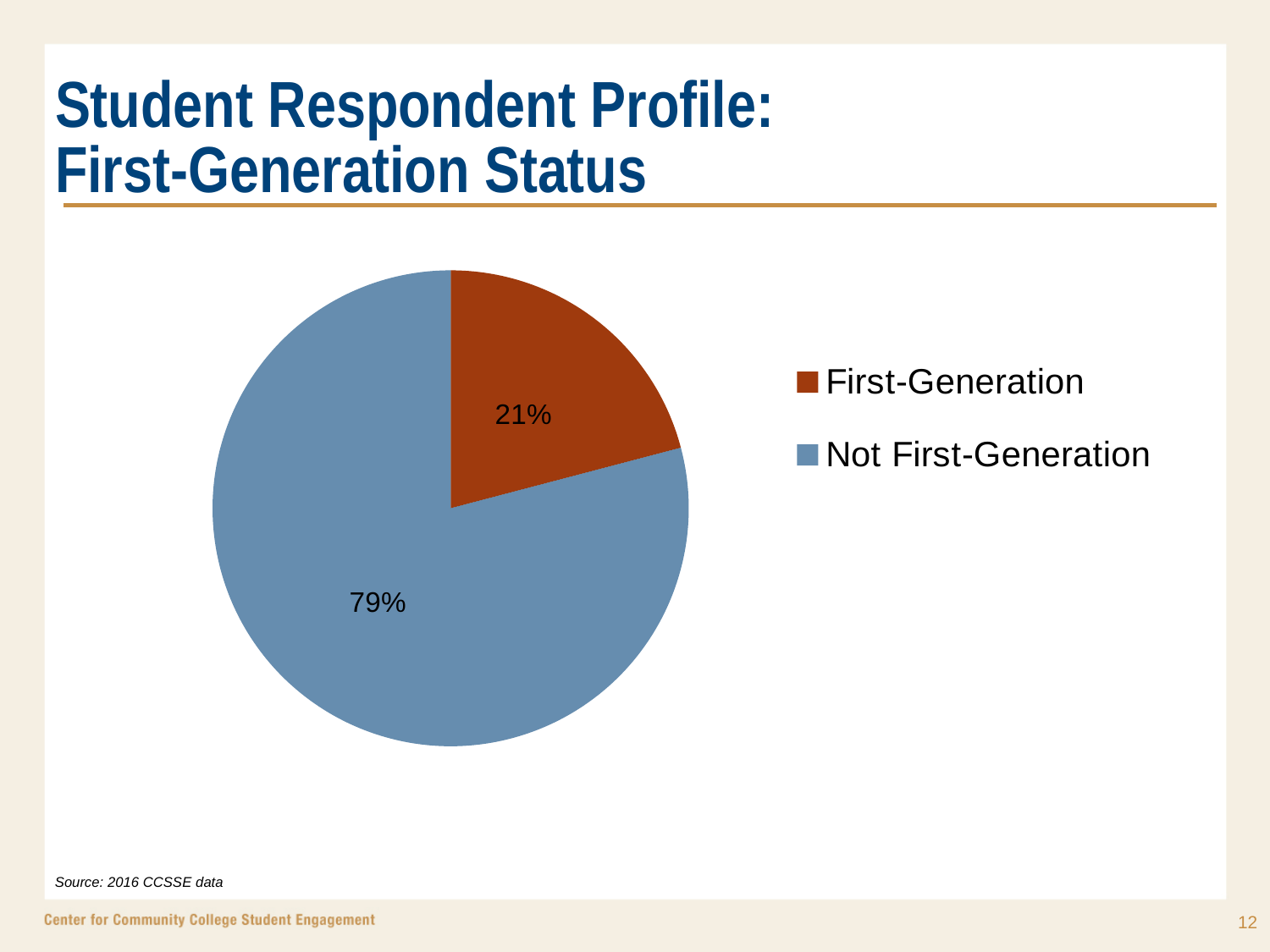
Which category has the largest share of the pie? Not First-Generation What is the source cited for the chart data? 2016 CCSSE data Which is larger, the First-Generation share or the Not First-Generation share? Not First-Generation How many entries does the legend list? 2 What is the difference in percentage points between Not First-Generation and First-Generation? 58 What share of the pie does the First-Generation slice represent? 21% How many slices does the pie chart have? 2 What colour is the First-Generation slice? Orange-brown What kind of chart is shown on the slide? Pie chart Which category has the smallest share of the pie? First-Generation What percentage of respondents are First-Generation? 21% What percentage of respondents are Not First-Generation? 79%